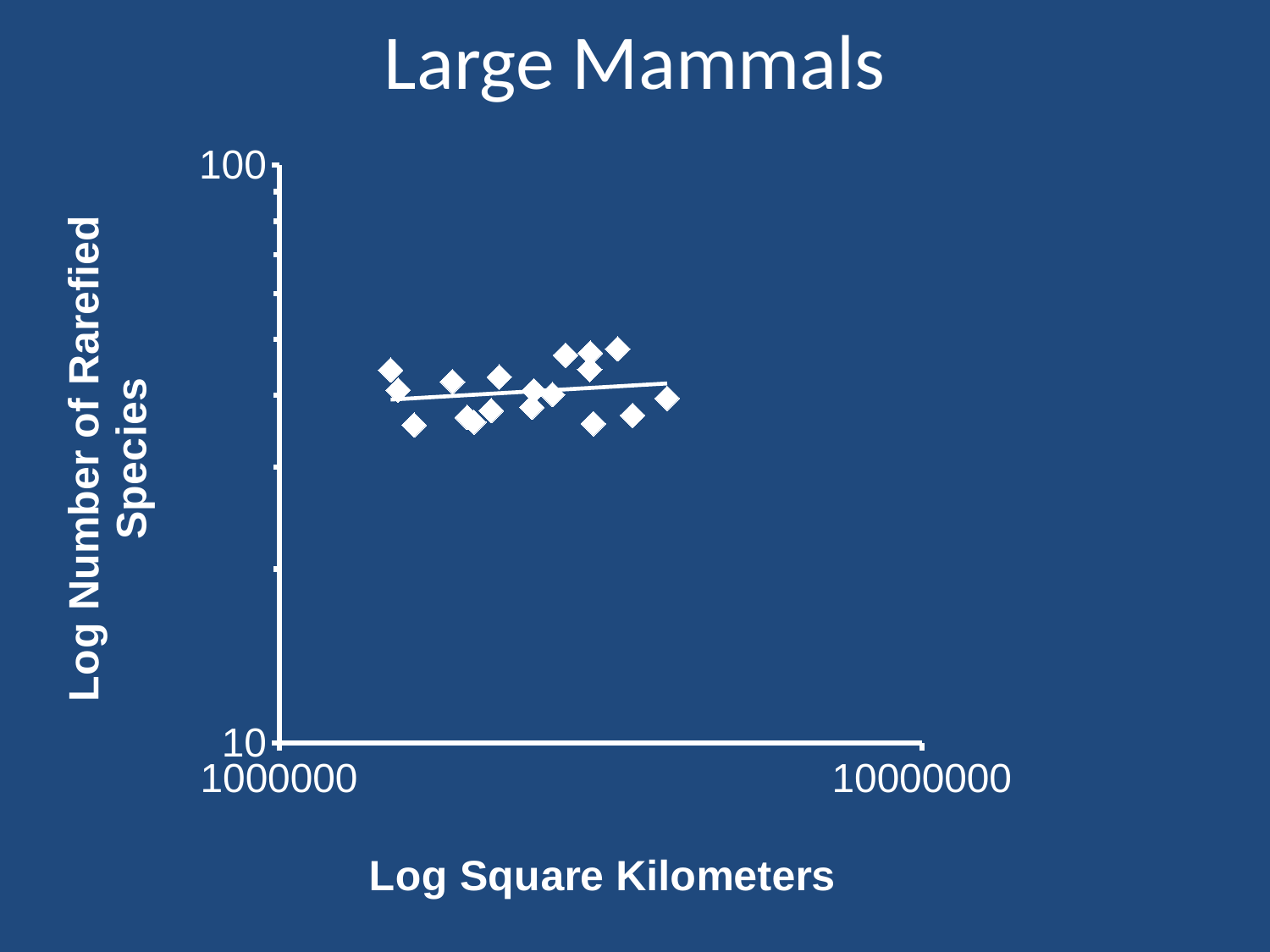
What is the leftmost tick value on the x axis? 1000000 Is the value of the lowest data point greater or less than 10? greater Does the fitted trend line rise steeply, fall steeply, or stay roughly flat across the x axis? Roughly flat (very slight rise) What is the title of the chart? Large Mammals What kind of chart is shown on the slide? Scatter plot Are all the data points located at x values less than 10000000? Yes What is the lowest value shown on the y axis? 10 What is the highest value shown on the y axis? 100 Is the value of the highest data point greater or less than 100? less What is the label of the x axis? Log Square Kilometers What is the rightmost tick value on the x axis? 10000000